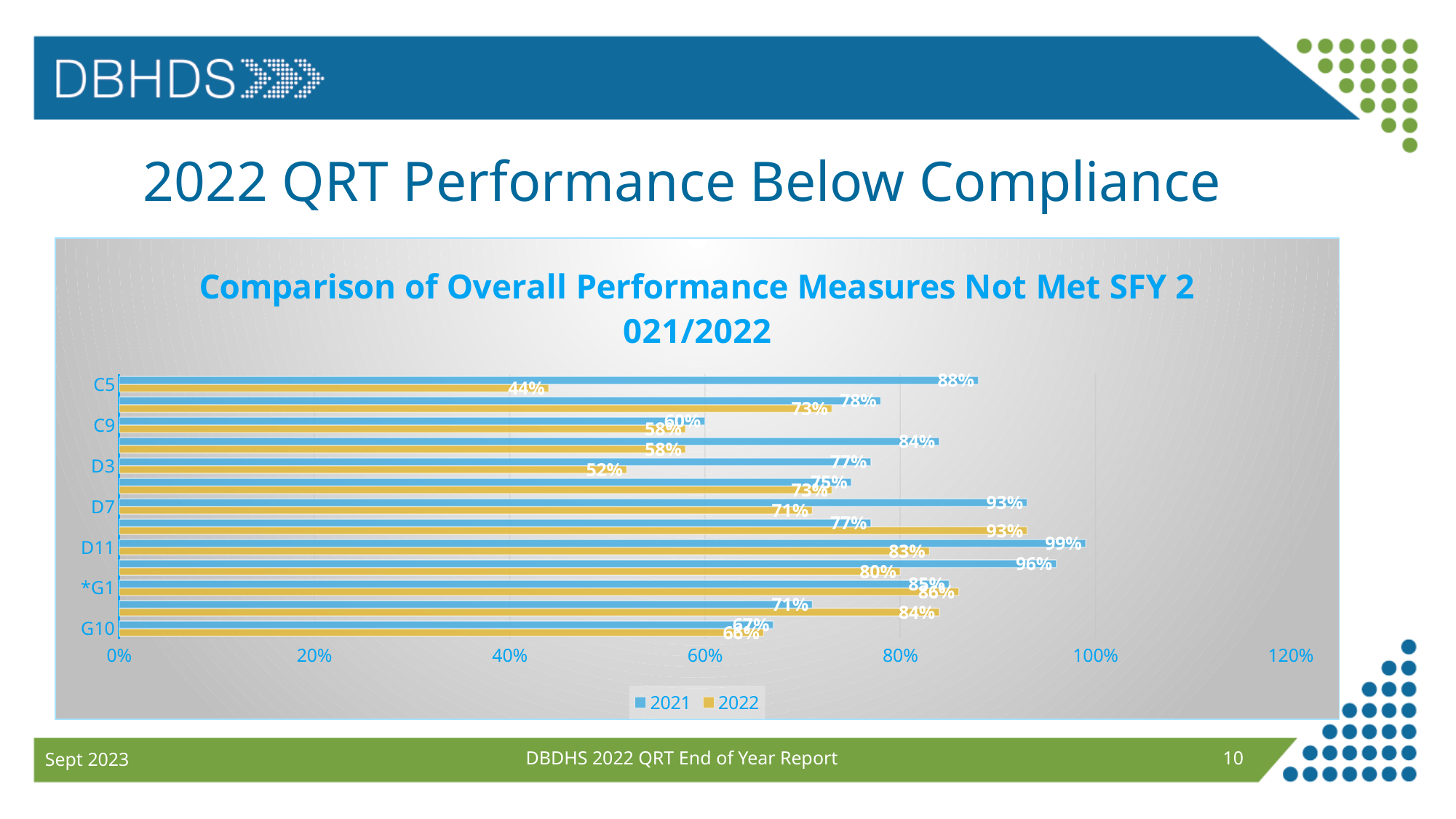
Which labeled category has the lowest 2022 value? C5 For D7, which series has the larger value, 2021 or 2022? 2021 What is the 2022 value for G10? 66% What kind of chart is shown on the slide? Bar chart Is the 2021 value for D11 greater or less than 80%? greater What is the difference between the 2021 and 2022 values for C5? 44% Which labeled category has the highest 2021 value? D11 What is the 2022 value for D7? 71% How many series does the legend list? 2 What is the 2021 value for C5? 88% What is the 2021 value for D11? 99% What is the 2022 value for C5? 44%